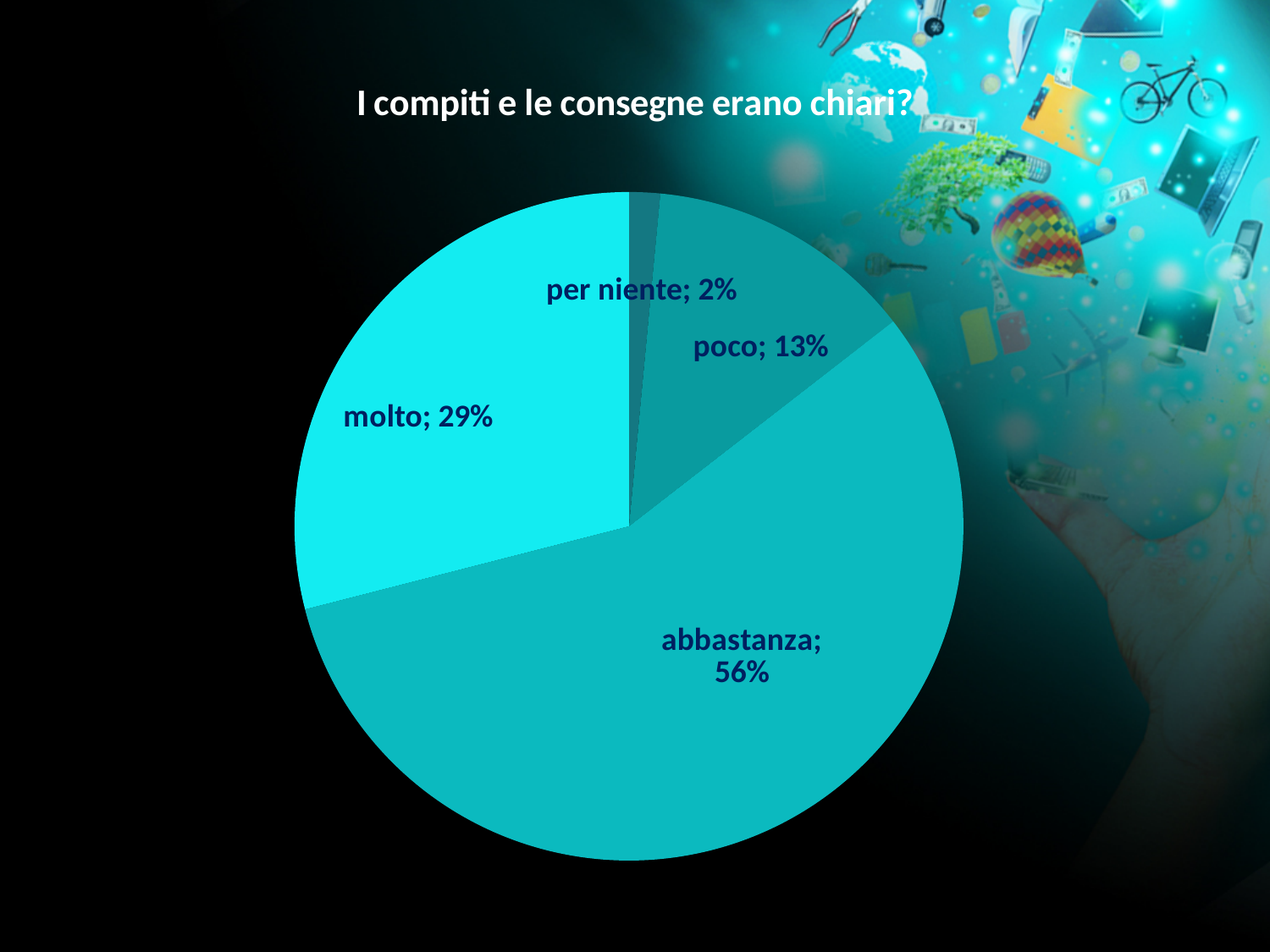
Which category has the largest slice of the pie? abbastanza What percentage is shown for "abbastanza"? 56% How many slices does the pie chart have? 4 Which category has the smallest slice of the pie? per niente What is the combined share of "abbastanza" and "molto"? 85% What percentage is shown for "poco"? 13% What percentage is shown for "molto"? 29% What type of chart is shown on the slide? pie chart What percentage is shown for "per niente"? 2% What is the difference in percentage points between "abbastanza" and "molto"? 27 What is the title of the chart? I compiti e le consegne erano chiari? Which is larger, the slice for "poco" or the slice for "molto"? molto